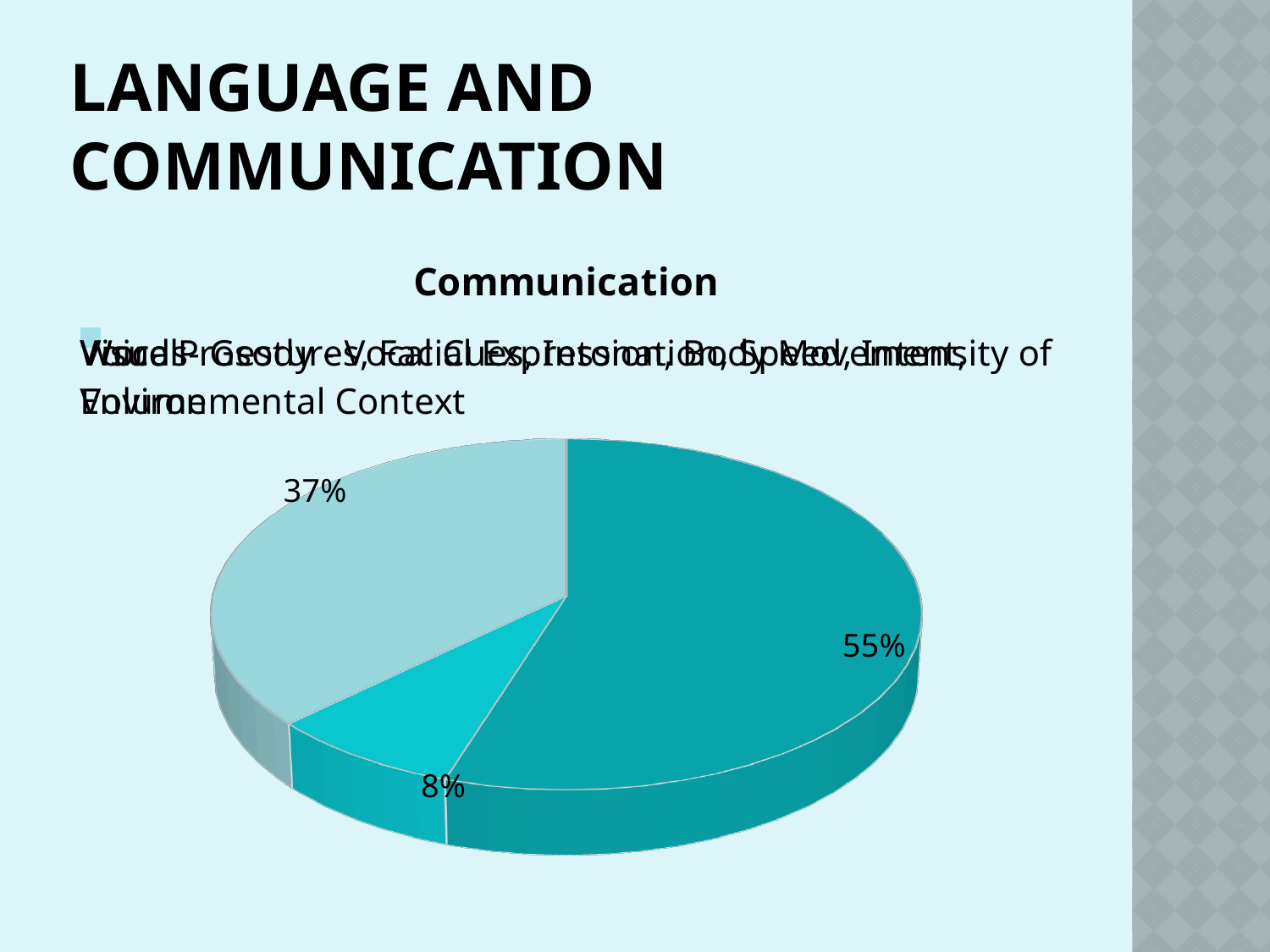
Which is larger, the slice on the right of the pie or the light-coloured slice on the left? the slice on the right (55%) What is the difference between the largest slice (55%) and the smallest slice (8%)? 47% What kind of chart is shown on the slide? pie chart What is the value of the slice on the right side of the pie chart? 55% What is the value of the smallest slice of the pie chart? 8% What is the difference between the 55% slice and the 37% slice? 18% What is the value of the largest slice of the pie chart? 55% Is the value of the largest slice greater or less than 50%? greater What is the value of the small slice at the bottom of the pie chart? 8% What is the title of the chart? Communication How many slices does the pie chart have? 3 What is the value of the light-coloured slice on the left side of the pie chart? 37%